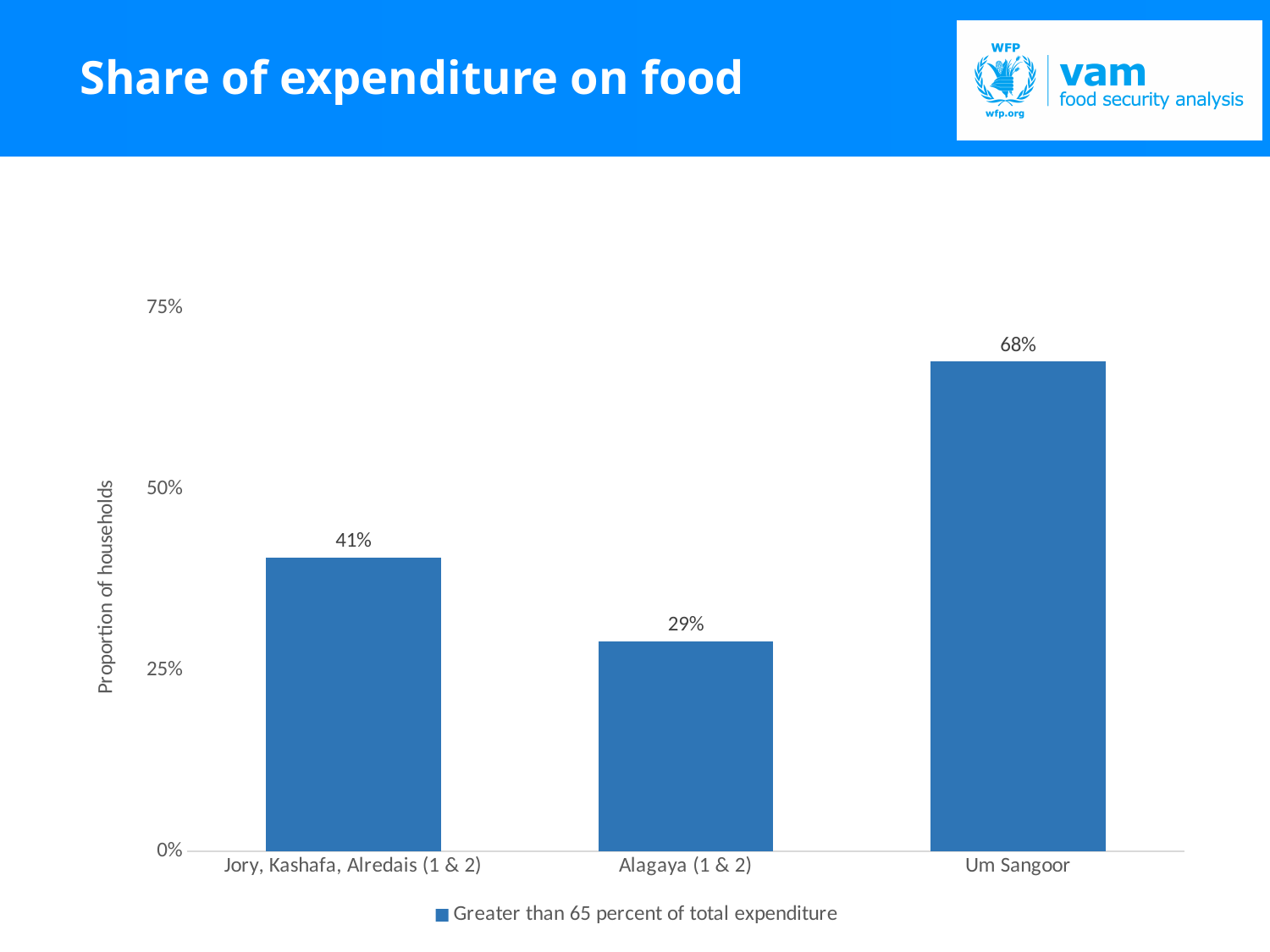
What is the value for Jory, Kashafa, Alredais (1 & 2)? 41% Is the value for Um Sangoor greater or less than 50%? greater What is the legend entry for the series shown? Greater than 65 percent of total expenditure What is the value for Alagaya (1 & 2)? 29% How many categories are shown on the x axis? 3 Which is larger, the value for Jory, Kashafa, Alredais (1 & 2) or the value for Alagaya (1 & 2)? Jory, Kashafa, Alredais (1 & 2) What is the difference between the values for Jory, Kashafa, Alredais (1 & 2) and Alagaya (1 & 2)? 12% What kind of chart is shown on the slide? bar chart What is the difference between the values for Um Sangoor and Alagaya (1 & 2)? 39% Which category has the lowest value? Alagaya (1 & 2) Which category has the highest value? Um Sangoor What is the value for Um Sangoor? 68%